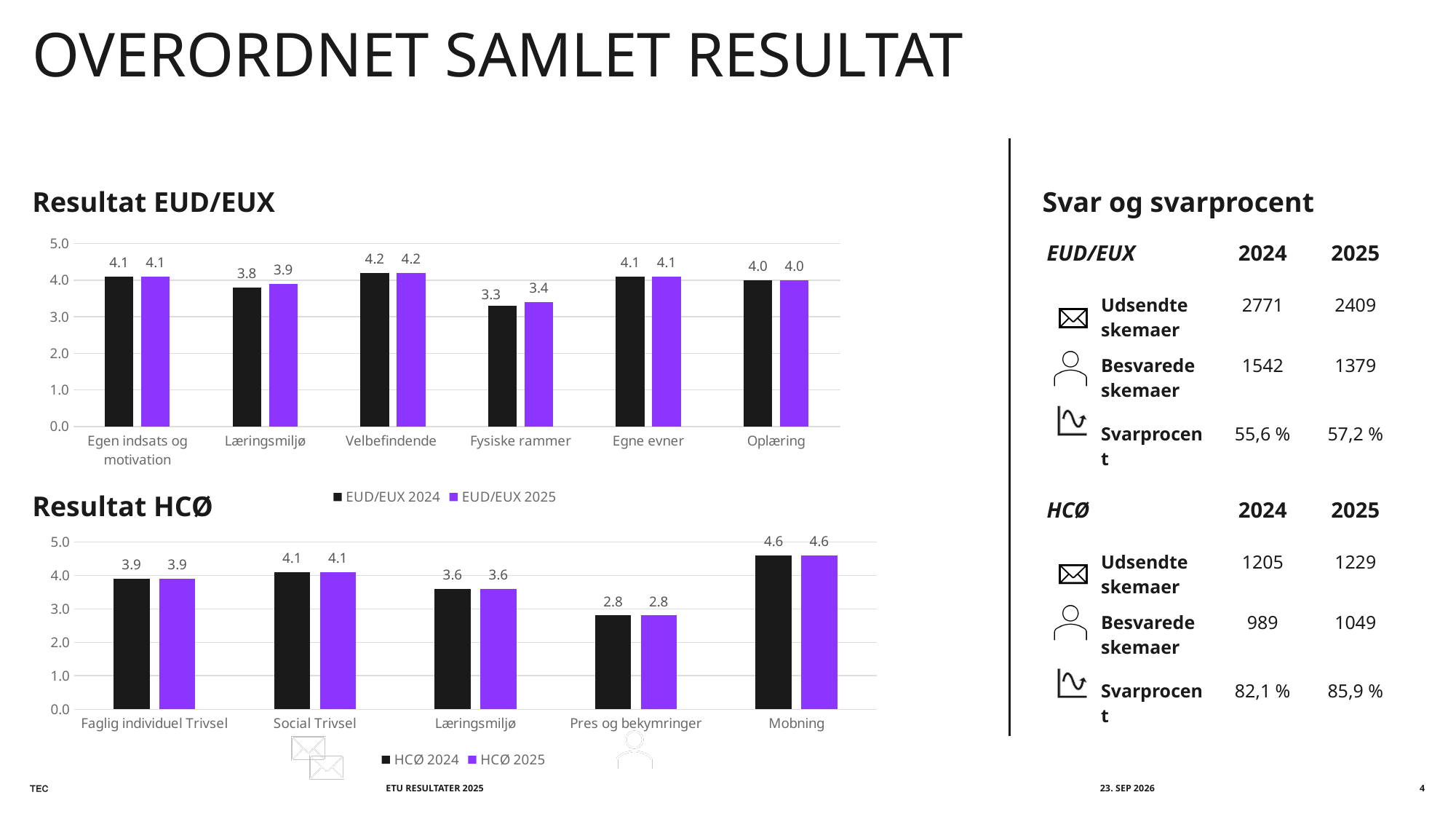
In the 'Resultat EUD/EUX' chart, what is the difference between the EUD/EUX 2025 and EUD/EUX 2024 values for Læringsmiljø? 0.1 How many series does the legend of the 'Resultat HCØ' chart list? 2 In the 'Resultat HCØ' chart, which category has the highest value in the HCØ 2024 series? Mobning In the 'Resultat EUD/EUX' chart, which category has the lowest value in the EUD/EUX 2024 series? Fysiske rammer In the 'Resultat EUD/EUX' chart, what is the value for Læringsmiljø in the EUD/EUX 2024 series? 3.8 How many categories are shown in the 'Resultat EUD/EUX' chart? 6 In the 'Resultat HCØ' chart, what is the value for Pres og bekymringer in the HCØ 2025 series? 2.8 What type of chart is the 'Resultat HCØ' chart? Bar chart In the 'Resultat HCØ' chart, which category has the lowest value in the HCØ 2025 series? Pres og bekymringer In the 'Resultat EUD/EUX' chart, which category has the highest value in the EUD/EUX 2025 series? Velbefindende In the 'Resultat HCØ' chart, what is the difference between the HCØ 2024 values for Mobning and Faglig individuel Trivsel? 0.7 In the 'Resultat EUD/EUX' chart, what is the value for Fysiske rammer in the EUD/EUX 2025 series? 3.4